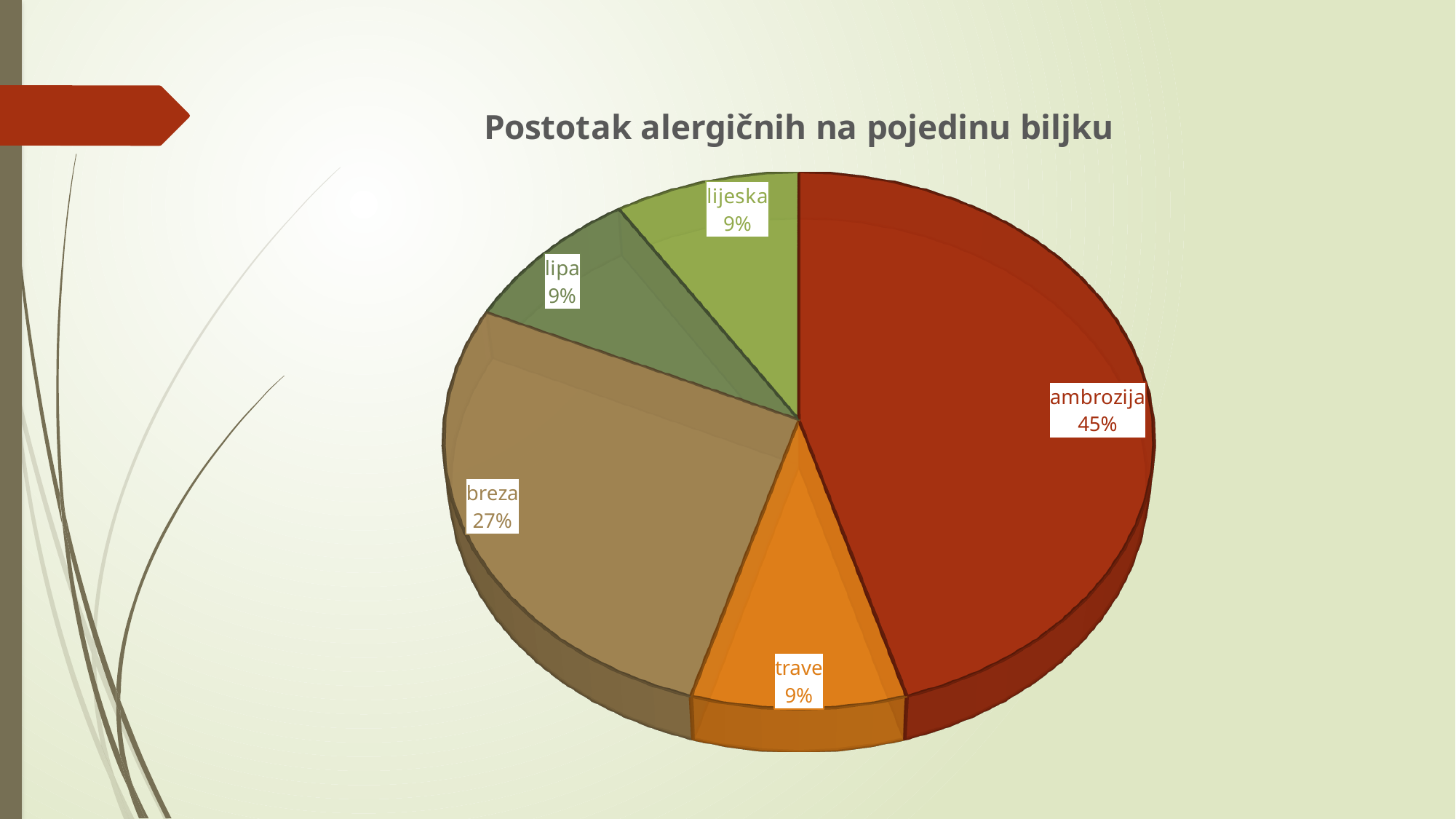
What percentage is shown for trave? 9% What percentage is shown for ambrozija? 45% What kind of chart is shown on the slide? pie chart What percentage is shown for lipa? 9% What percentage is shown for breza? 27% What is the title of the chart? Postotak alergičnih na pojedinu biljku How many slices does the pie chart have? 5 Which is larger, the share for breza or the share for lijeska? breza Which plant has the largest share of the pie? ambrozija What colour is the ambrozija slice? red What is the combined share of ambrozija and breza? 72% What is the difference in percentage points between ambrozija and breza? 18